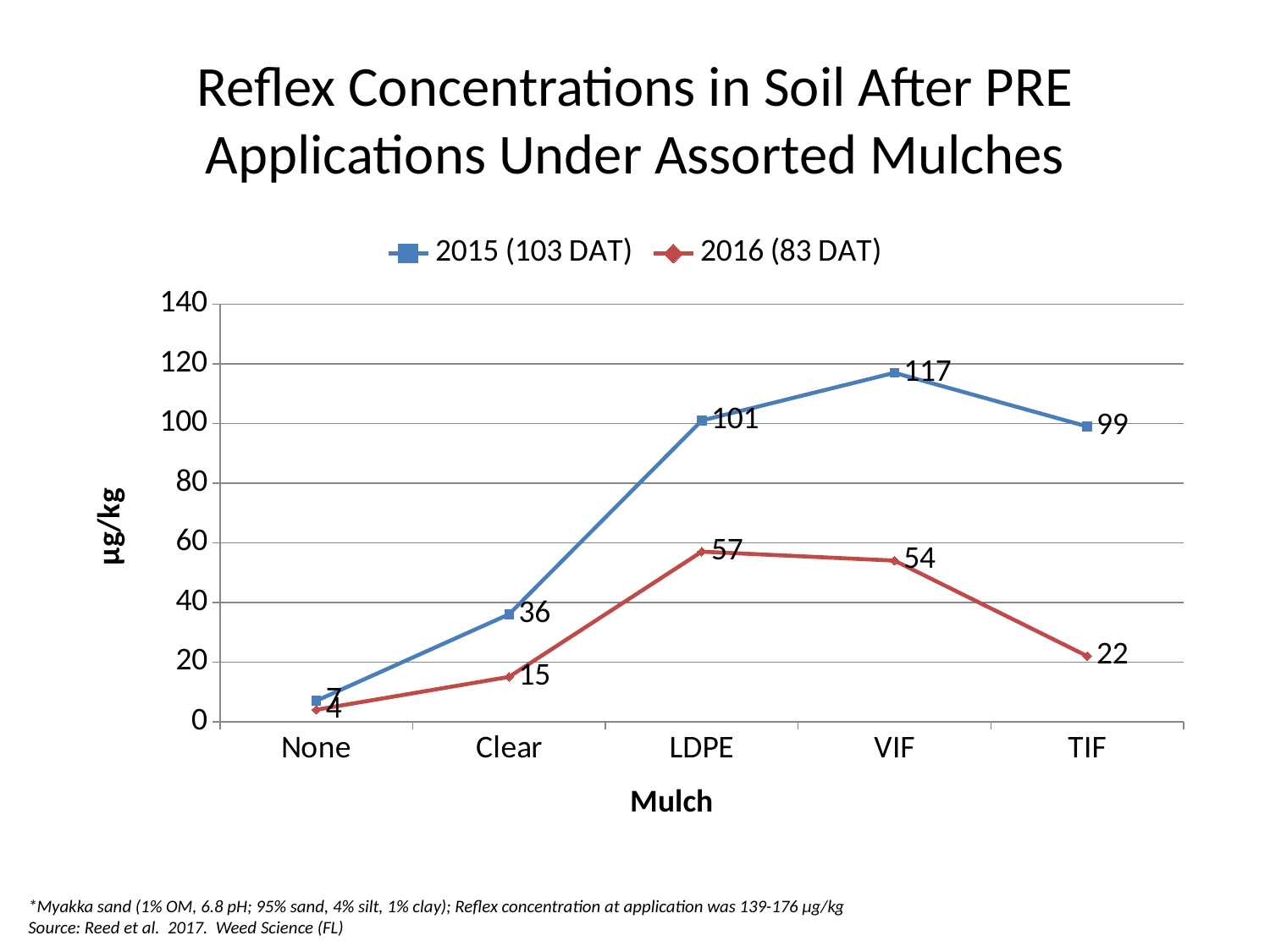
What is the 2015 (103 DAT) value for VIF? 117 Which is larger for TIF: the 2015 (103 DAT) value or the 2016 (83 DAT) value? 2015 (103 DAT) What is the 2015 (103 DAT) value for Clear mulch? 36 How many series does the legend list? 2 What is the 2016 (83 DAT) value for TIF? 22 Which mulch has the lowest 2016 (83 DAT) value? None What is the label on the y axis? µg/kg What is the 2016 (83 DAT) value for LDPE? 57 What is the difference between the 2015 (103 DAT) and 2016 (83 DAT) values for LDPE? 44 Which mulch has the highest 2015 (103 DAT) value? VIF How many mulch categories are shown on the x axis? 5 What kind of chart is shown on the slide? line chart